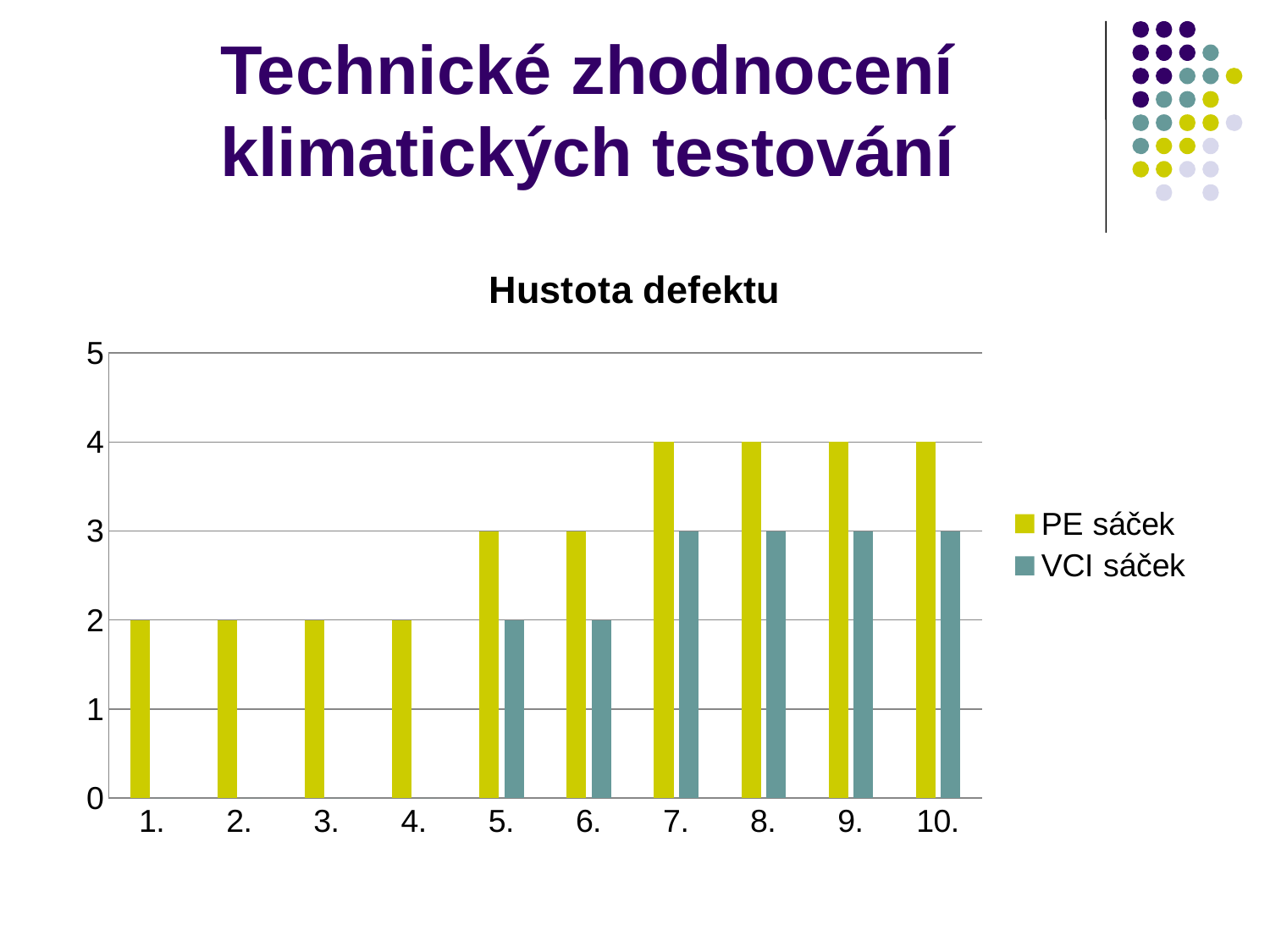
What is the value for VCI sáček at category 7.? 3 Which colour represents the VCI sáček series? teal Which series has the larger value at category 8., PE sáček or VCI sáček? PE sáček How many categories are shown on the x axis? 10 Do the PE sáček values rise or fall from category 1. to category 10.? rise What is the difference between PE sáček and VCI sáček at category 10.? 1 What is the value for PE sáček at category 1.? 2 What is the value for VCI sáček at category 6.? 2 What is the value for PE sáček at category 5.? 3 What kind of chart is shown on the slide? bar chart What is the title of the chart? Hustota defektu How many series does the legend list? 2